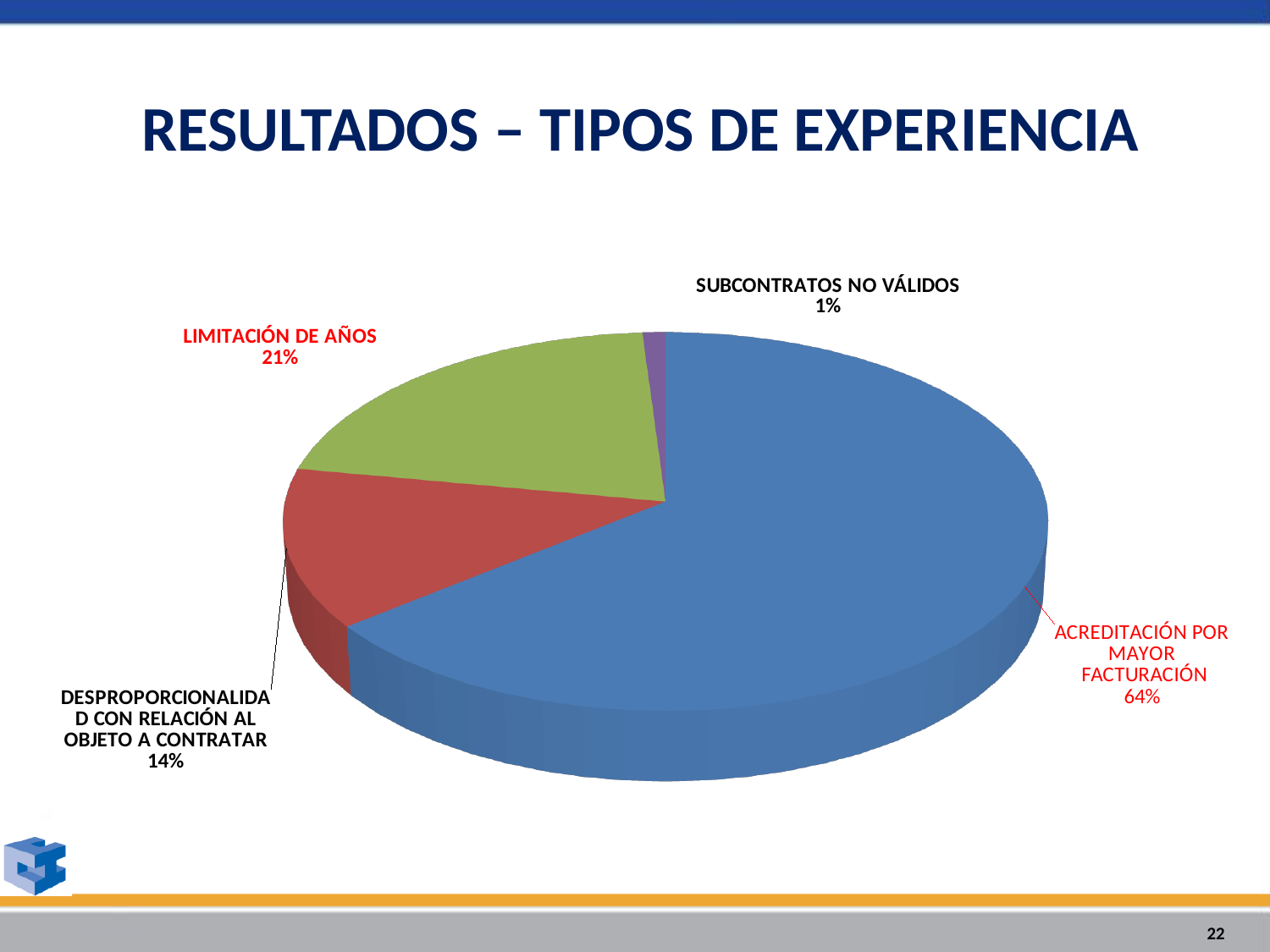
How many categories are shown in the pie chart? 4 Which category has the smallest slice of the pie? SUBCONTRATOS NO VÁLIDOS What share of the pie does ACREDITACIÓN POR MAYOR FACTURACIÓN represent? 64% What percentage is shown for DESPROPORCIONALIDAD CON RELACIÓN AL OBJETO A CONTRATAR? 14% What colour is the slice for LIMITACIÓN DE AÑOS? Green Which is larger, LIMITACIÓN DE AÑOS or DESPROPORCIONALIDAD CON RELACIÓN AL OBJETO A CONTRATAR? LIMITACIÓN DE AÑOS What percentage is shown for SUBCONTRATOS NO VÁLIDOS? 1% What kind of chart is shown on the slide? Pie chart What is the difference in percentage points between ACREDITACIÓN POR MAYOR FACTURACIÓN and LIMITACIÓN DE AÑOS? 43 What percentage is shown for LIMITACIÓN DE AÑOS? 21% What is the title of the slide containing the chart? RESULTADOS – TIPOS DE EXPERIENCIA Which category has the largest slice of the pie? ACREDITACIÓN POR MAYOR FACTURACIÓN